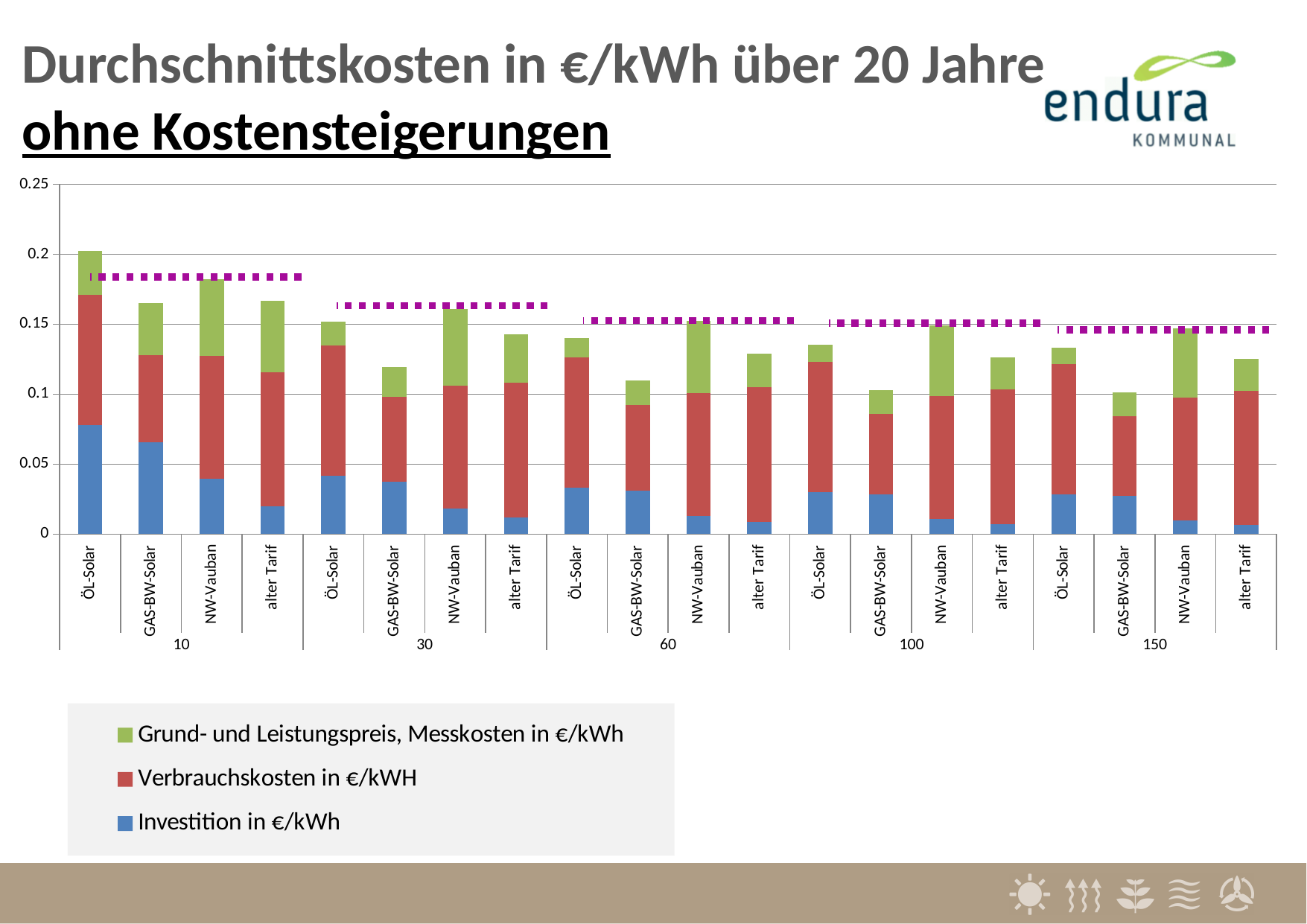
What kind of chart is shown on the slide? stacked bar chart Is the total for NW-Vauban in group 10 greater or less than 0.15? greater How many series does the legend list? 3 Within group 10, which bar is taller: ÖL-Solar or GAS-BW-Solar? ÖL-Solar Does the total for ÖL-Solar rise or fall from group 10 to group 150? fall Which bar has the highest total in the chart? ÖL-Solar in group 10 How many bars are plotted in the chart? 20 Which series is shown in blue according to the legend? Investition in €/kWh How many groups (10, 30, 60, 100, 150) are shown along the x axis? 5 Is the total for alter Tarif in group 150 greater or less than 0.1? greater Is the total for GAS-BW-Solar in group 60 greater or less than 0.15? less